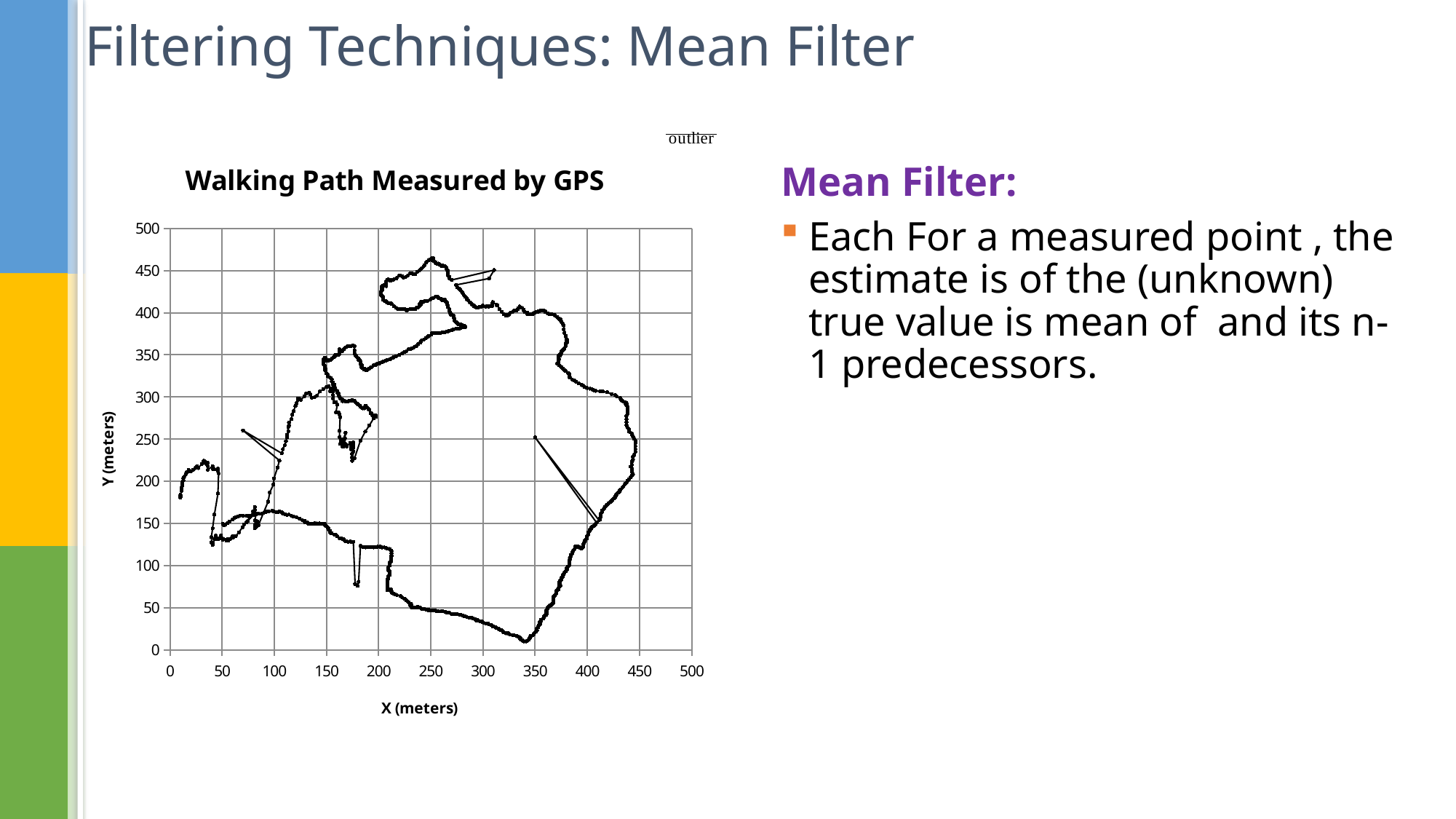
Is the highest Y value reached by the walking path greater or less than 450? greater Is the smallest X value reached by the walking path greater or less than 50? less What kind of chart is shown on the slide? scatter chart Is the highest Y value reached by the walking path greater or less than 400? greater What is the label of the horizontal axis of the chart? X (meters) What is the title of the chart on the slide? Walking Path Measured by GPS